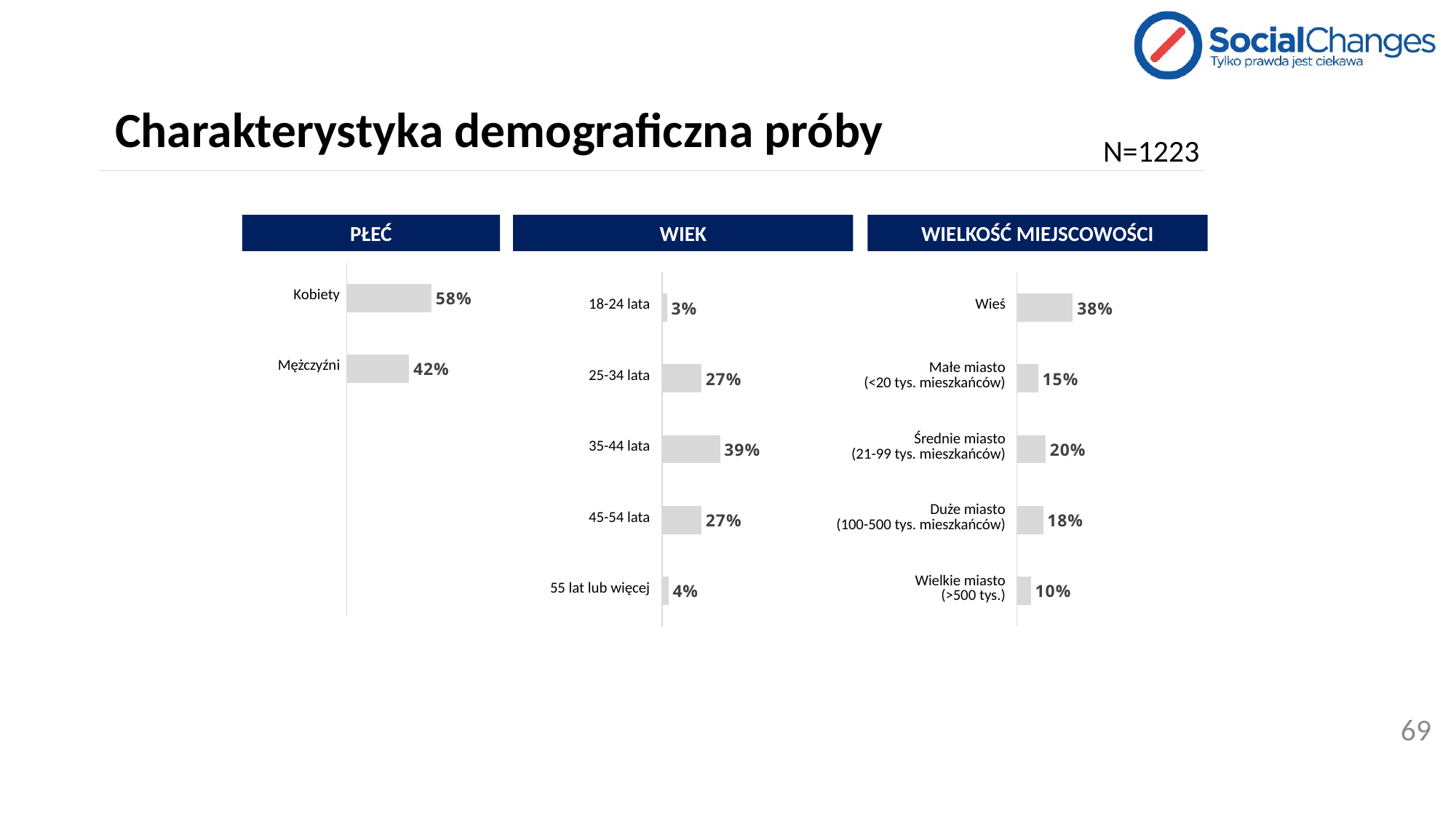
In the PŁEĆ chart, what is the difference between Kobiety and Mężczyźni? 16% In the PŁEĆ chart, what is the value for Kobiety? 58% What type of chart is used in the WIEK section? Bar chart In the WIEK chart, what is the value for 35-44 lata? 39% In the WIEK chart, how many age categories are shown? 5 In the WIEK chart, which age group has the lowest value? 18-24 lata In the WIELKOŚĆ MIEJSCOWOŚCI chart, what is the value for Wieś? 38% In the WIEK chart, what is the value for 55 lat lub więcej? 4% In the WIELKOŚĆ MIEJSCOWOŚCI chart, which is larger: Średnie miasto (21-99 tys. mieszkańców) or Duże miasto (100-500 tys. mieszkańców)? Średnie miasto (21-99 tys. mieszkańców) In the WIELKOŚĆ MIEJSCOWOŚCI chart, which category has the lowest value? Wielkie miasto (>500 tys.) In the WIEK chart, which age group has the highest value? 35-44 lata In the WIELKOŚĆ MIEJSCOWOŚCI chart, what is the difference between Wieś and Małe miasto (<20 tys. mieszkańców)? 23%